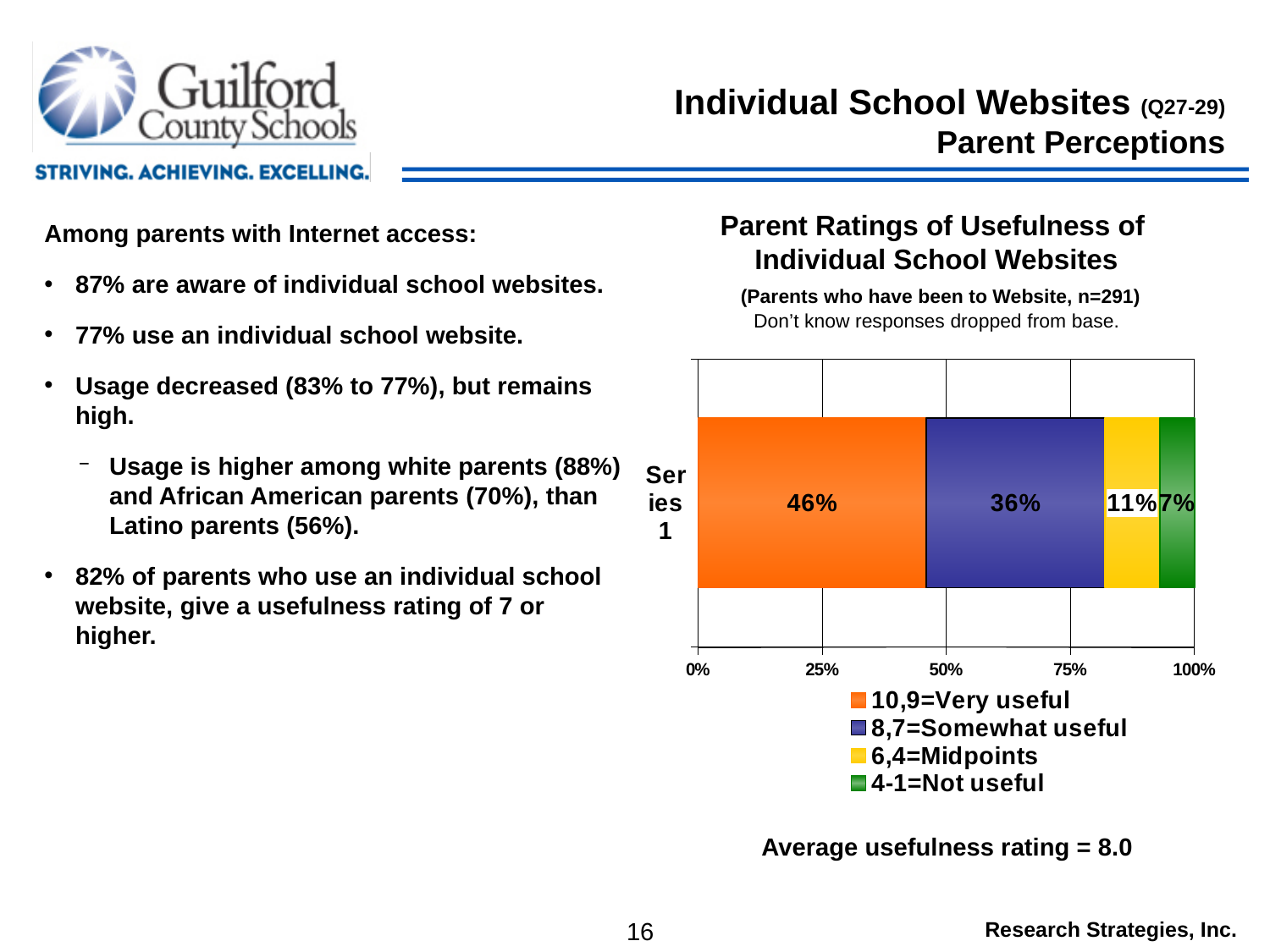
What percentage of parents gave a 'Midpoints' (6,4) rating? 11% How many segments make up the stacked bar? 4 What percentage of parents rated the websites 'Not useful' (4-1)? 7% What type of chart is shown on the slide? Stacked bar chart What colour represents the '10,9=Very useful' category in the chart? Orange What percentage of parents gave a 'Somewhat useful' (8,7) rating? 36% What percentage of parents rated individual school websites as 'Very useful' (10,9)? 46% Which rating category has the smallest share of the bar? 4-1=Not useful Which is larger, the 'Midpoints' segment or the 'Not useful' segment? 6,4=Midpoints Which rating category has the largest share of the bar? 10,9=Very useful How many entries does the legend list? 4 What is the difference in percentage points between the 'Very useful' and 'Somewhat useful' segments? 10